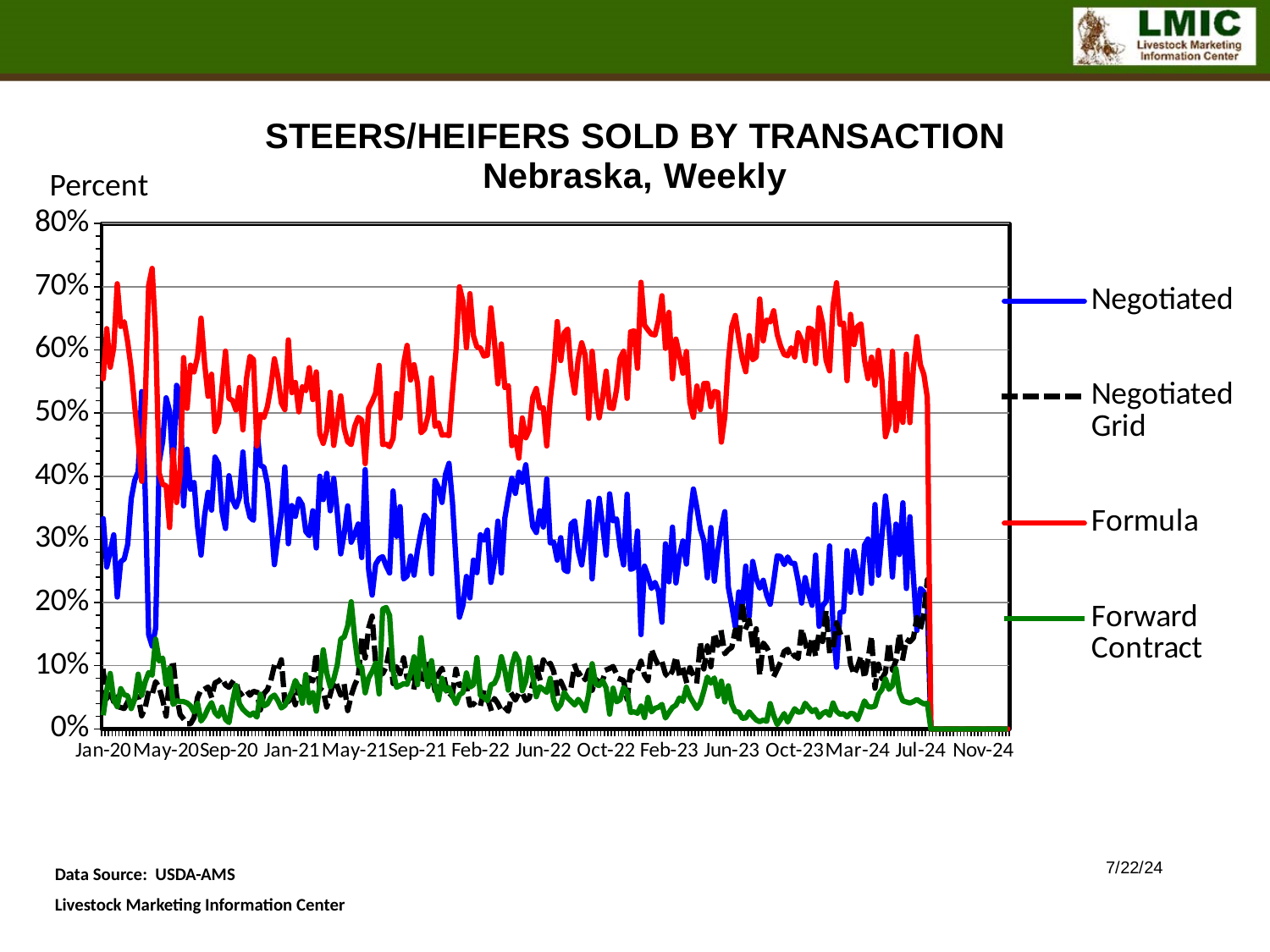
Does the Negotiated series generally rise or fall from 2021 to 2024? Fall What is the title of the chart? STEERS/HEIFERS SOLD BY TRANSACTION, Nebraska, Weekly Which series has the lowest values during 2023 and 2024? Forward Contract Is the value for Formula around Feb-23 greater or less than 50%? greater Around Feb-22, which is larger, Formula or Negotiated? Formula Which colour is used for the Formula series? Red What kind of chart is shown on the slide? Line chart Is the value for Forward Contract around Jan-22 greater or less than 20%? less Is the value for Negotiated at Jan-20 greater or less than 50%? less Around Jun-23, which is larger, Negotiated Grid or Forward Contract? Negotiated Grid How many series does the legend list? 4 Which series reaches the highest value on the chart? Formula